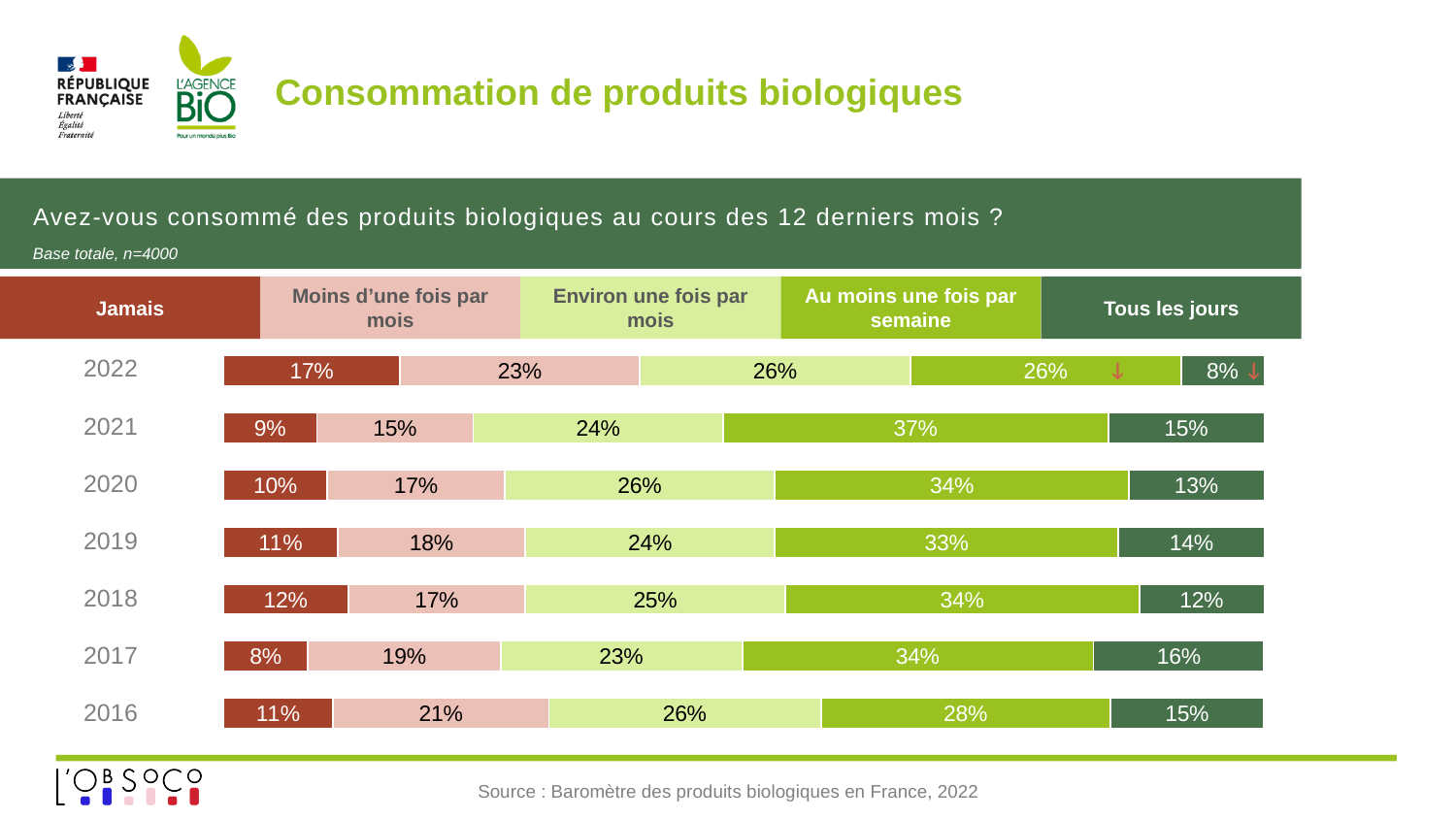
What percentage of respondents answered "Au moins une fois par semaine" in 2016? 28% What kind of chart is shown on the slide? Stacked bar chart How many response categories does the legend list? 5 What is the combined share of "Au moins une fois par semaine" and "Tous les jours" in 2022? 34% How many years are shown in the chart? 7 What is the sample size stated under the question on the slide? n=4000 Which is larger: the "Moins d'une fois par mois" share in 2016 or in 2021? 2016 What percentage of respondents answered "Tous les jours" in 2021? 15% In which year was the "Tous les jours" share the lowest? 2022 What percentage of respondents answered "Jamais" in 2022? 17% In which year was the "Au moins une fois par semaine" share the highest? 2021 What is the difference between the "Jamais" share in 2022 and in 2021? 8 percentage points